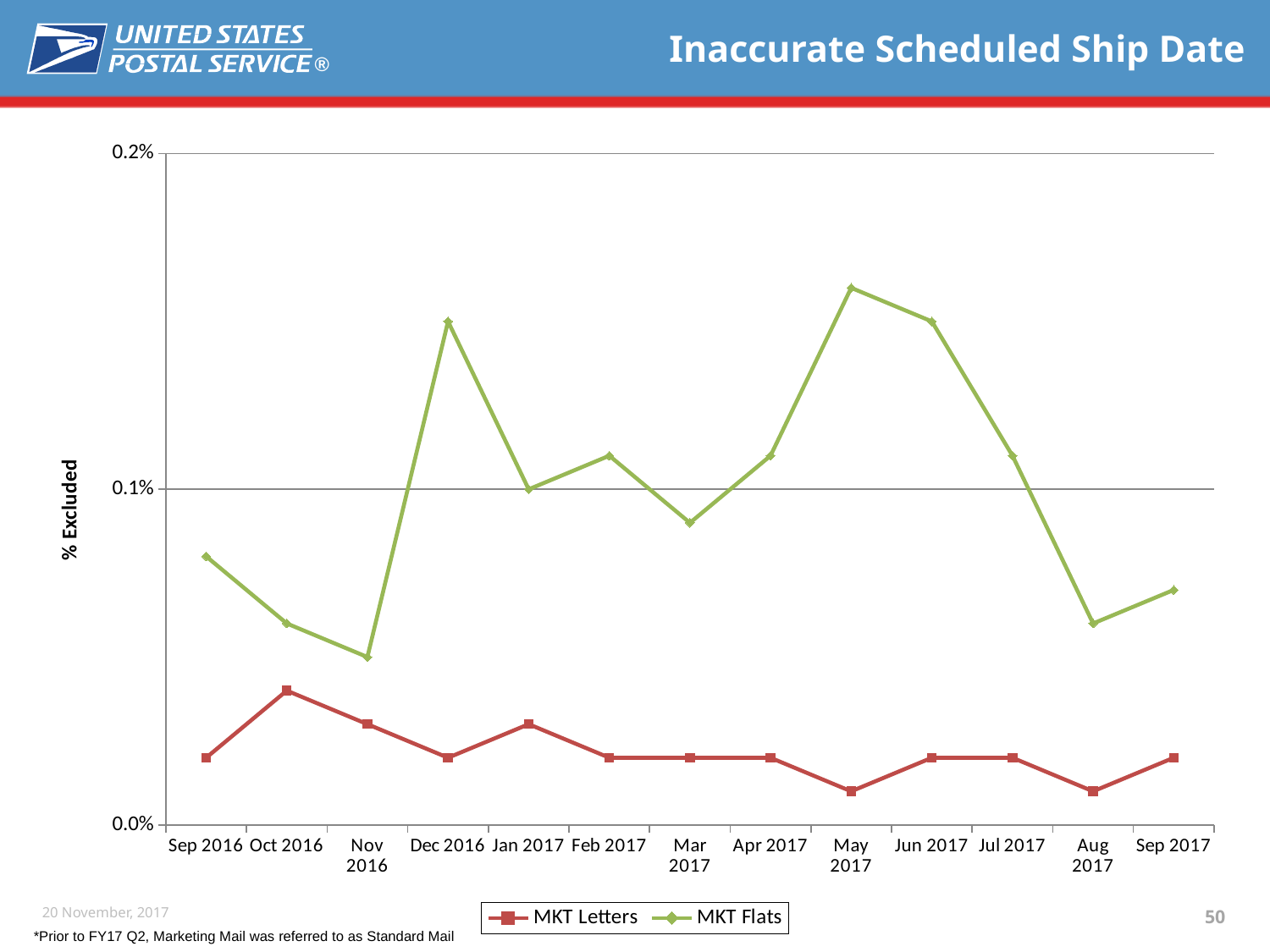
What kind of chart is shown on the slide? line chart In which month does the MKT Letters series reach its highest value? Oct 2016 In which month does the MKT Flats series reach its lowest value? Nov 2016 Is the value for MKT Letters in May 2017 greater or less than 0.1%? less How many series does the legend list? 2 What is the label on the vertical axis of the chart? % Excluded In which month does the MKT Flats series reach its highest value? May 2017 In May 2017, which series has the larger value, MKT Letters or MKT Flats? MKT Flats How many months are plotted along the x axis? 13 Does the MKT Flats series rise or fall from Jul 2017 to Aug 2017? fall Is the value for MKT Flats in Sep 2016 greater or less than 0.1%? less Is the value for MKT Flats in Dec 2016 greater or less than 0.1%? greater